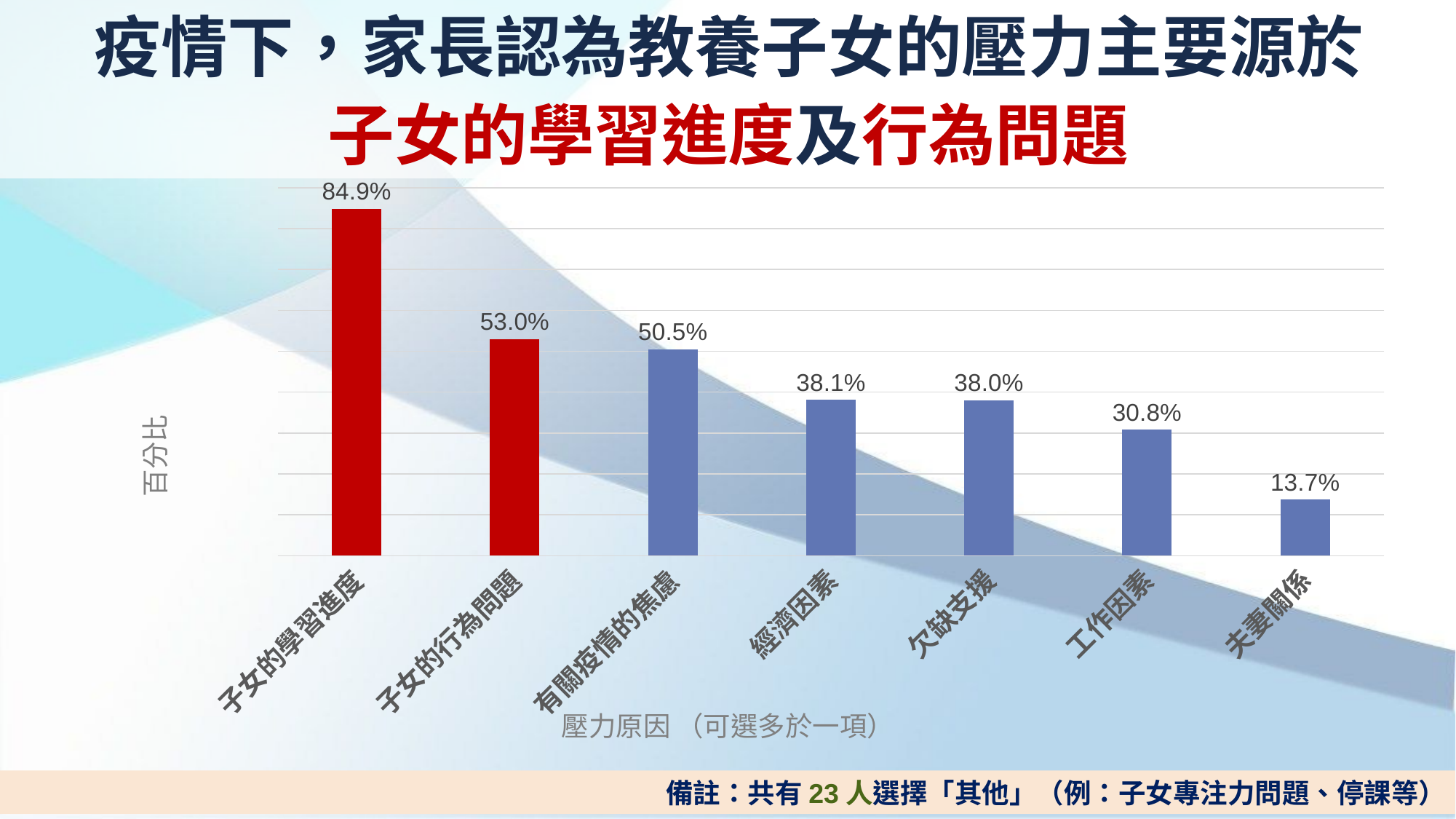
What is the difference between the values for 子女的學習進度 and 子女的行為問題? 31.9% What is the difference between the values for 有關疫情的焦慮 and 工作因素? 19.7% What is the value for 子女的學習進度? 84.9% What is the value for 經濟因素? 38.1% Which is larger, the value for 子女的行為問題 or the value for 有關疫情的焦慮? 子女的行為問題 Which category has the lowest value? 夫妻關係 What is the x-axis title of the chart? 壓力原因（可選多於一項） What kind of chart is shown on the slide? bar chart What is the value for 夫妻關係? 13.7% Do the values rise or fall from left to right along the x axis? fall Which category has the highest value? 子女的學習進度 How many categories are shown on the x axis? 7